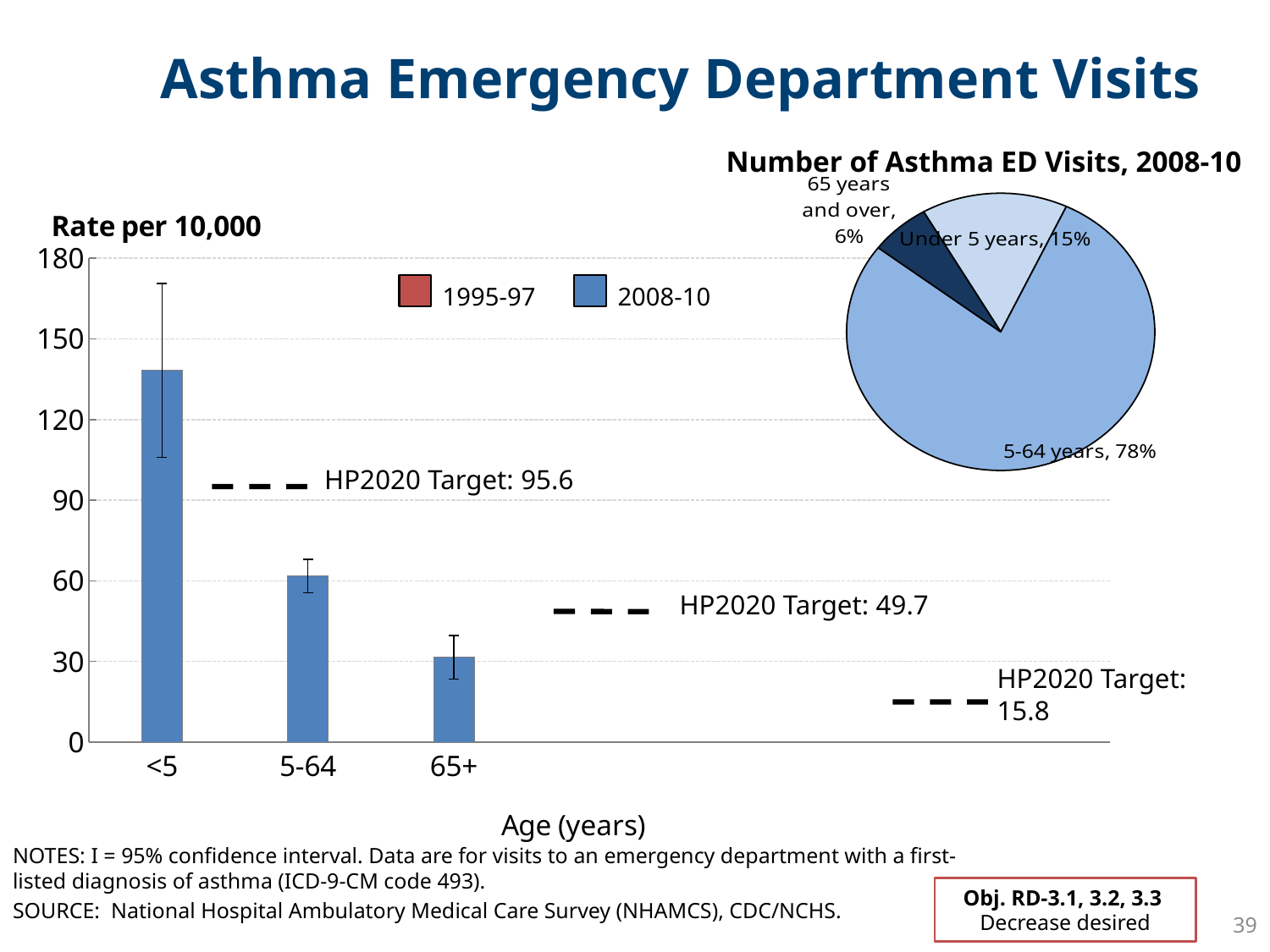
In the bar chart on the left, is the rate for the <5 age group greater or less than 120? greater In the bar chart on the left, what kind of chart is it? bar chart In the bar chart on the left, how many age groups are shown on the x axis? 3 In the pie chart titled 'Number of Asthma ED Visits, 2008-10', what is the difference in percentage points between the 5-64 years share and the Under 5 years share? 63 In the bar chart on the left, which age group has the highest rate per 10,000? <5 In the bar chart on the left, how many series does the legend list? 2 In the bar chart on the left, do the rates rise or fall as age increases along the x axis? fall In the bar chart on the left, which age group has the lowest rate per 10,000? 65+ In the pie chart titled 'Number of Asthma ED Visits, 2008-10', which age group has the smallest share? 65 years and over In the bar chart on the left, what is the HP2020 Target shown for the <5 age group? 95.6 In the pie chart titled 'Number of Asthma ED Visits, 2008-10', what share of visits is for 5-64 years? 78% In the bar chart on the left, is the rate for the 65+ age group greater or less than 60? less